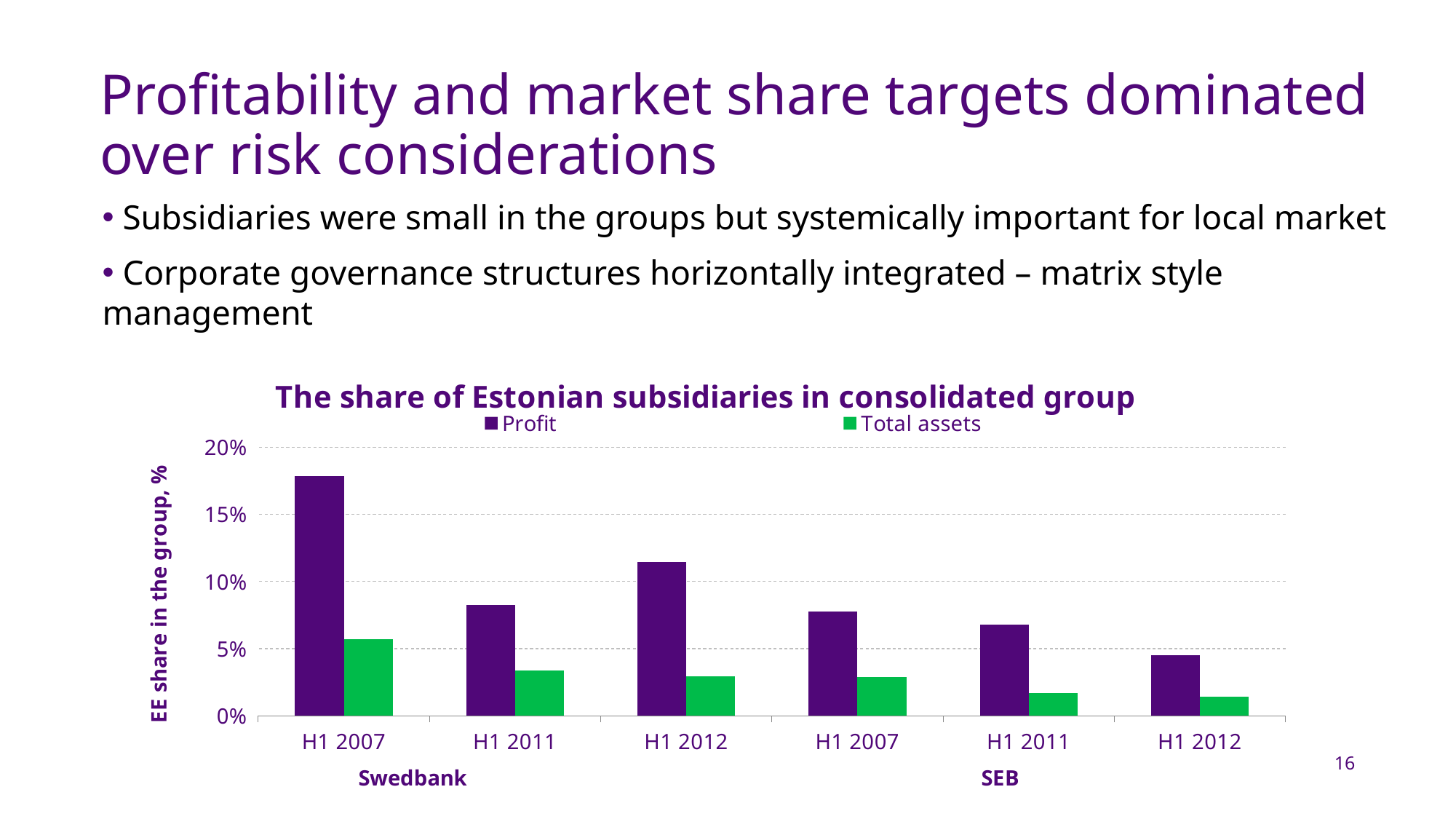
Which is larger for Swedbank: the Profit share in H1 2011 or in H1 2012? H1 2012 How many period categories are shown along the x axis of the chart? 6 How many series does the legend of the chart list? 2 What kind of chart is shown on the slide? bar chart Is the Profit value for Swedbank H1 2012 greater or less than 10%? greater Is the Profit value for SEB H1 2012 greater or less than 5%? less Is the Total assets value for SEB H1 2011 greater or less than 5%? less Which category has the lowest Profit share in the chart? SEB H1 2012 Which category has the highest Profit share in the chart? Swedbank H1 2007 What is the title of the chart's vertical axis? EE share in the group, % Do the Profit values for SEB rise or fall from H1 2007 to H1 2012? fall